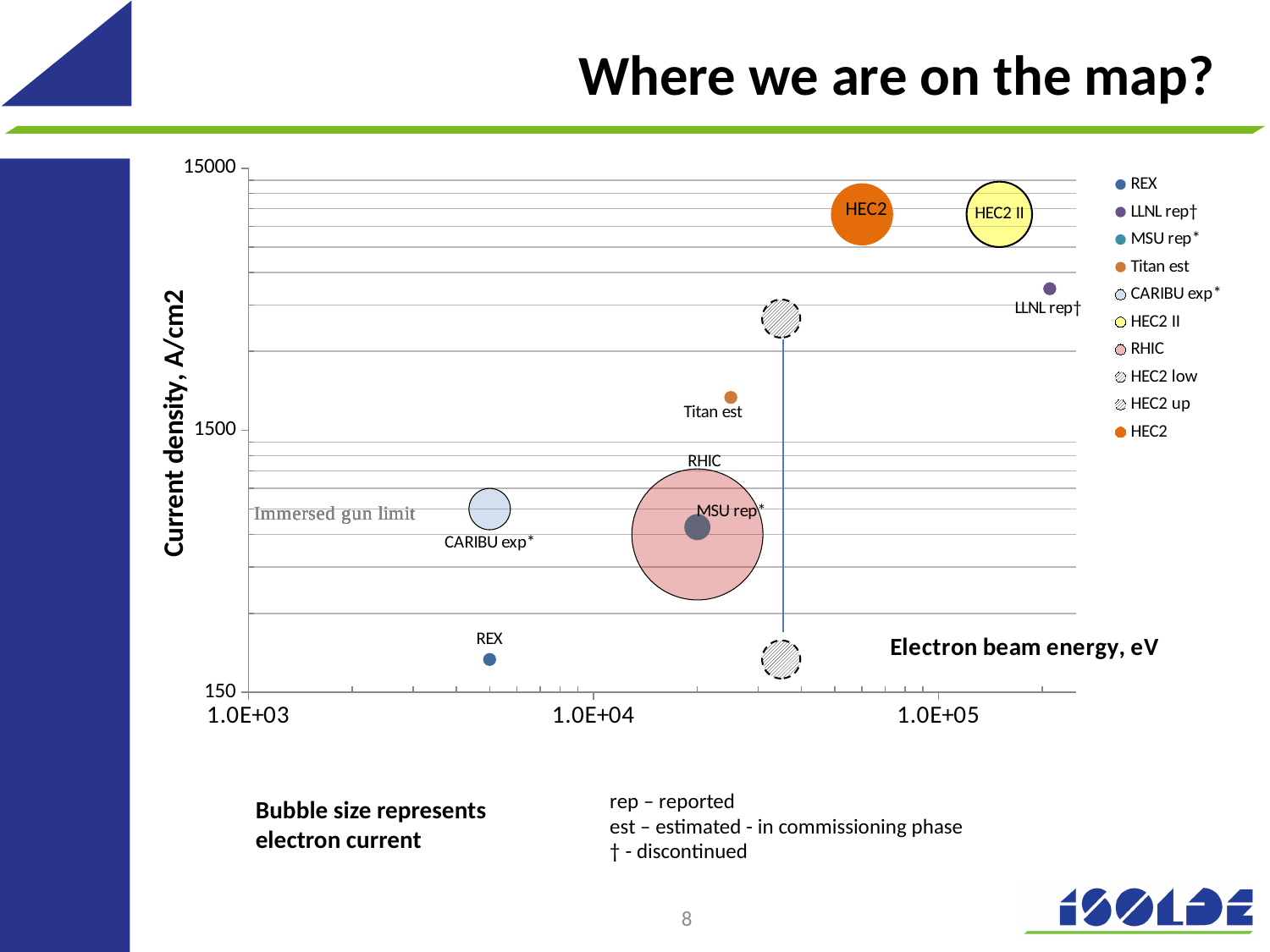
How many series does the chart legend list? 10 Which series has the highest electron beam energy on the chart? LLNL rep† What does the bubble size represent in the chart? electron current Is the current density for HEC2 greater or less than 1500? greater What is the title of the vertical axis of the chart? Current density, A/cm2 Which has the larger current density, HEC2 or REX? HEC2 Which series has the lowest current density on the chart? REX and HEC2 low (tied) Is the current density for REX greater or less than 1500? less Is the electron beam energy for HEC2 greater or less than 1.0E+04? greater What kind of chart is shown on the slide? bubble chart